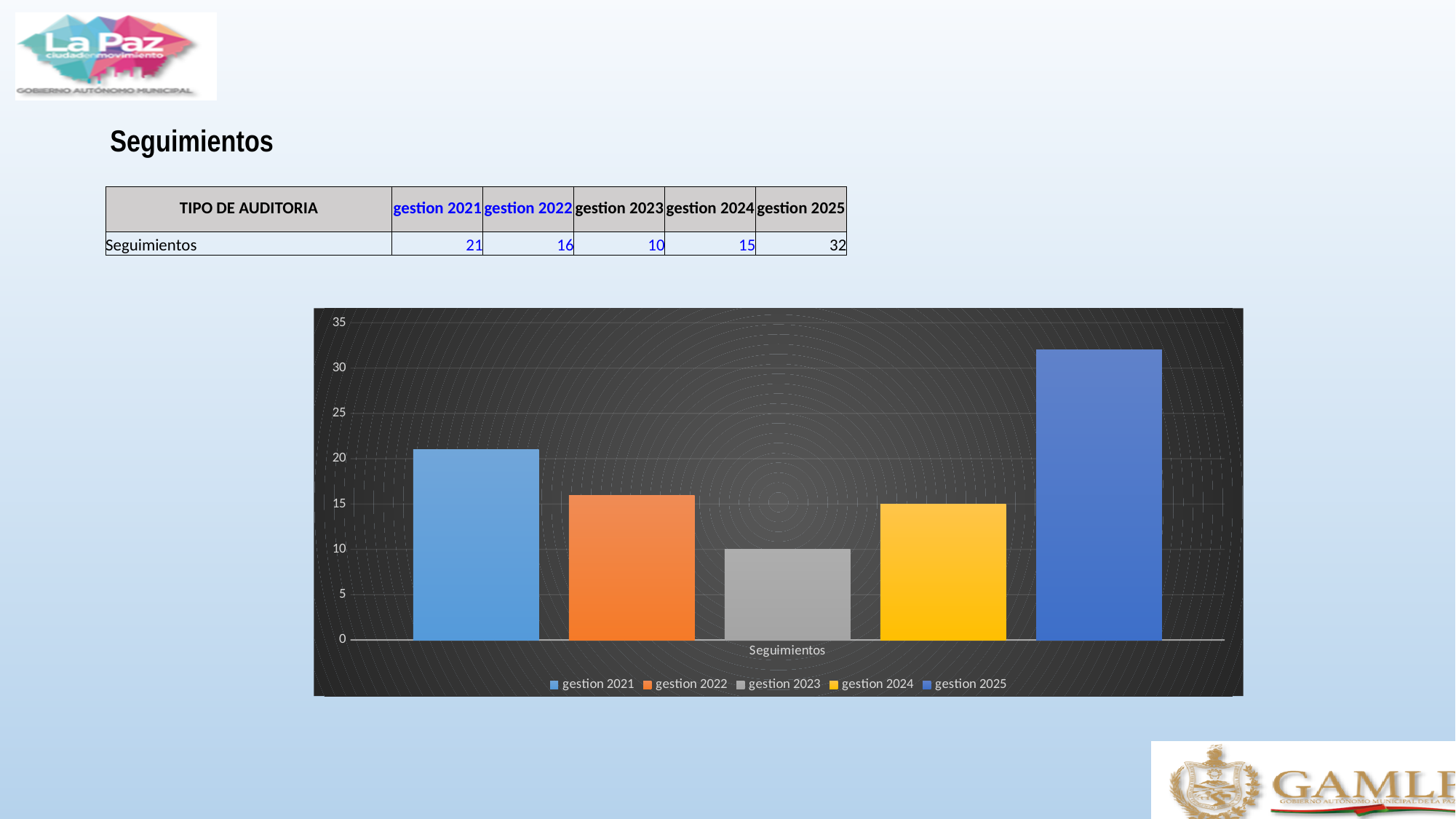
Which series has the lowest value in the Seguimientos chart? gestion 2023 What is the difference between the values for gestion 2025 and gestion 2021? 11 What kind of chart is shown on the slide? bar chart What is the difference between the values for gestion 2022 and gestion 2024? 1 What is the value for gestion 2023 in the Seguimientos chart? 10 Which series has the highest value in the Seguimientos chart? gestion 2025 Which is larger, the value for gestion 2021 or the value for gestion 2024? gestion 2021 Is the value for gestion 2025 greater or less than 30? greater What is the value for gestion 2021 in the Seguimientos chart? 21 How many series does the legend of the chart list? 5 What is the category label shown on the x axis of the chart? Seguimientos What is the value for gestion 2025 in the Seguimientos chart? 32